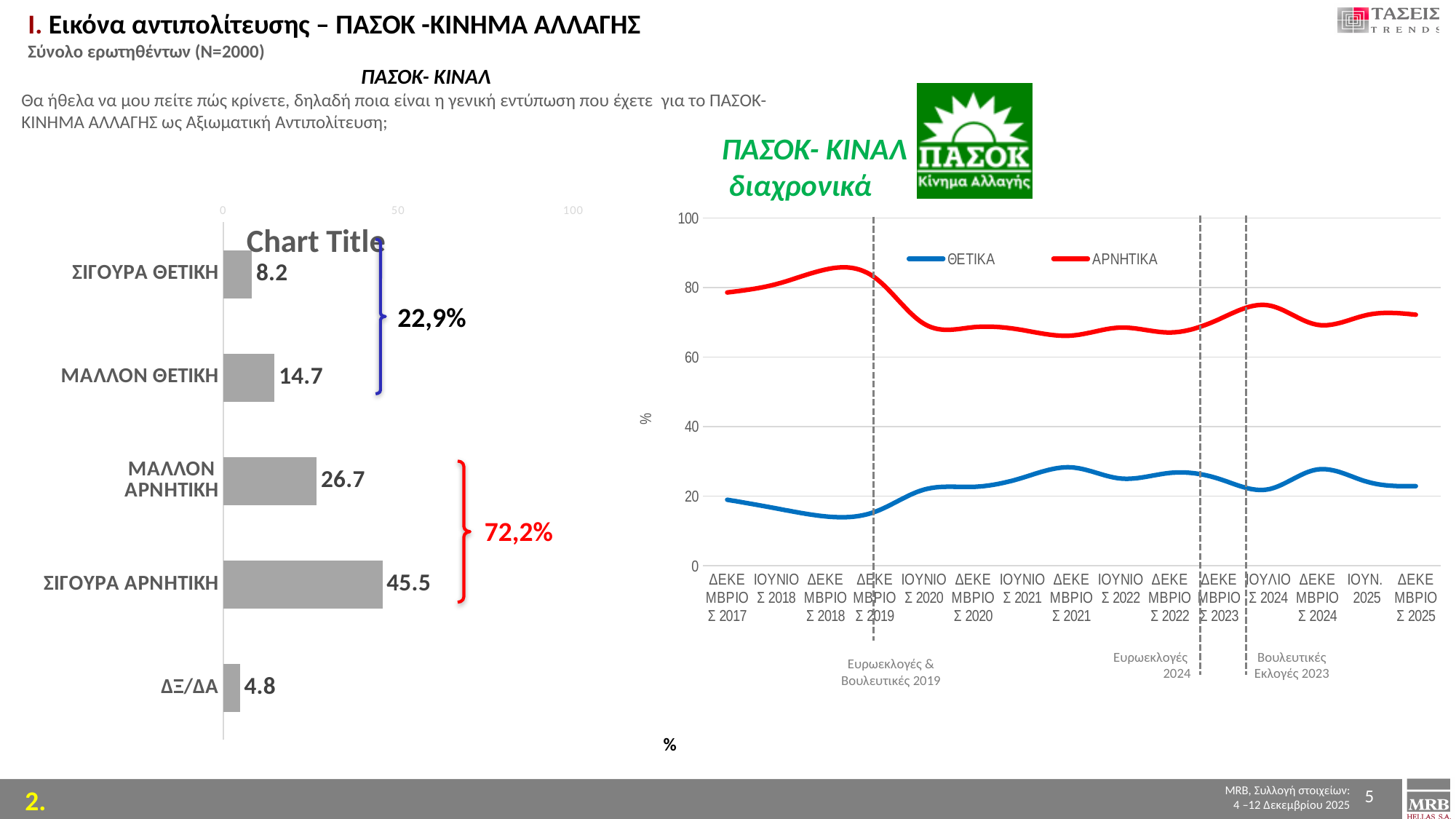
How many series does the legend of the ΠΑΣΟΚ-ΚΙΝΑΛ διαχρονικά line chart list? 2 In the bar chart on the left, which category has the lowest value? ΔΞ/ΔΑ In the bar chart on the left, what is the value for ΣΙΓΟΥΡΑ ΑΡΝΗΤΙΚΗ? 45.5 In the bar chart on the left, what is the value for ΜΑΛΛΟΝ ΘΕΤΙΚΗ? 14.7 How many categories does the bar chart on the left show? 5 In the bar chart on the left, what is the difference between the values for ΣΙΓΟΥΡΑ ΑΡΝΗΤΙΚΗ and ΜΑΛΛΟΝ ΑΡΝΗΤΙΚΗ? 18.8 What kind of chart is the chart on the left of the slide? Bar chart In the bar chart on the left, which is larger: ΣΙΓΟΥΡΑ ΘΕΤΙΚΗ or ΜΑΛΛΟΝ ΘΕΤΙΚΗ? ΜΑΛΛΟΝ ΘΕΤΙΚΗ In the ΠΑΣΟΚ-ΚΙΝΑΛ διαχρονικά line chart, which series is higher at ΔΕΚΕΜΒΡΙΟΣ 2025: ΘΕΤΙΚΑ or ΑΡΝΗΤΙΚΑ? ΑΡΝΗΤΙΚΑ In the ΠΑΣΟΚ-ΚΙΝΑΛ διαχρονικά line chart, is the ΑΡΝΗΤΙΚΑ value for ΔΕΚΕΜΒΡΙΟΣ 2018 greater or less than 80? greater In the ΠΑΣΟΚ-ΚΙΝΑΛ διαχρονικά line chart, is the ΘΕΤΙΚΑ value for ΔΕΚΕΜΒΡΙΟΣ 2018 greater or less than 20? less In the bar chart on the left, which category has the highest value? ΣΙΓΟΥΡΑ ΑΡΝΗΤΙΚΗ